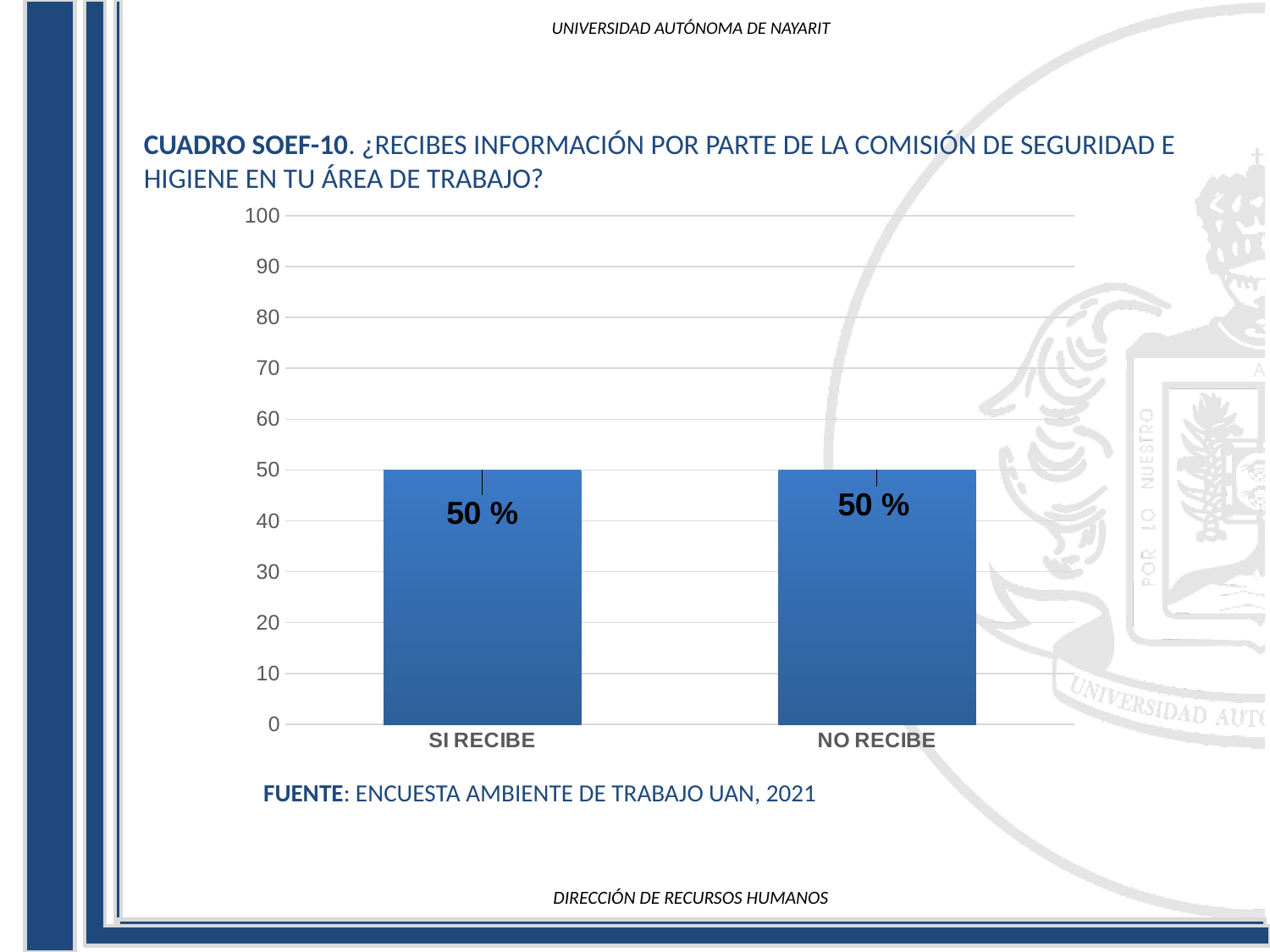
How many categories are shown on the x axis? 2 What is the value for SI RECIBE? 50 % What is the highest value shown on the y axis? 100 What is the total of the values for SI RECIBE and NO RECIBE? 100 % Is the value for NO RECIBE greater or less than 20? greater What is the difference between the values for SI RECIBE and NO RECIBE? 0 What kind of chart is shown on the slide? bar chart What source is cited below the chart? ENCUESTA AMBIENTE DE TRABAJO UAN, 2021 Is the value for SI RECIBE greater or less than 80? less What is the value for NO RECIBE? 50 %